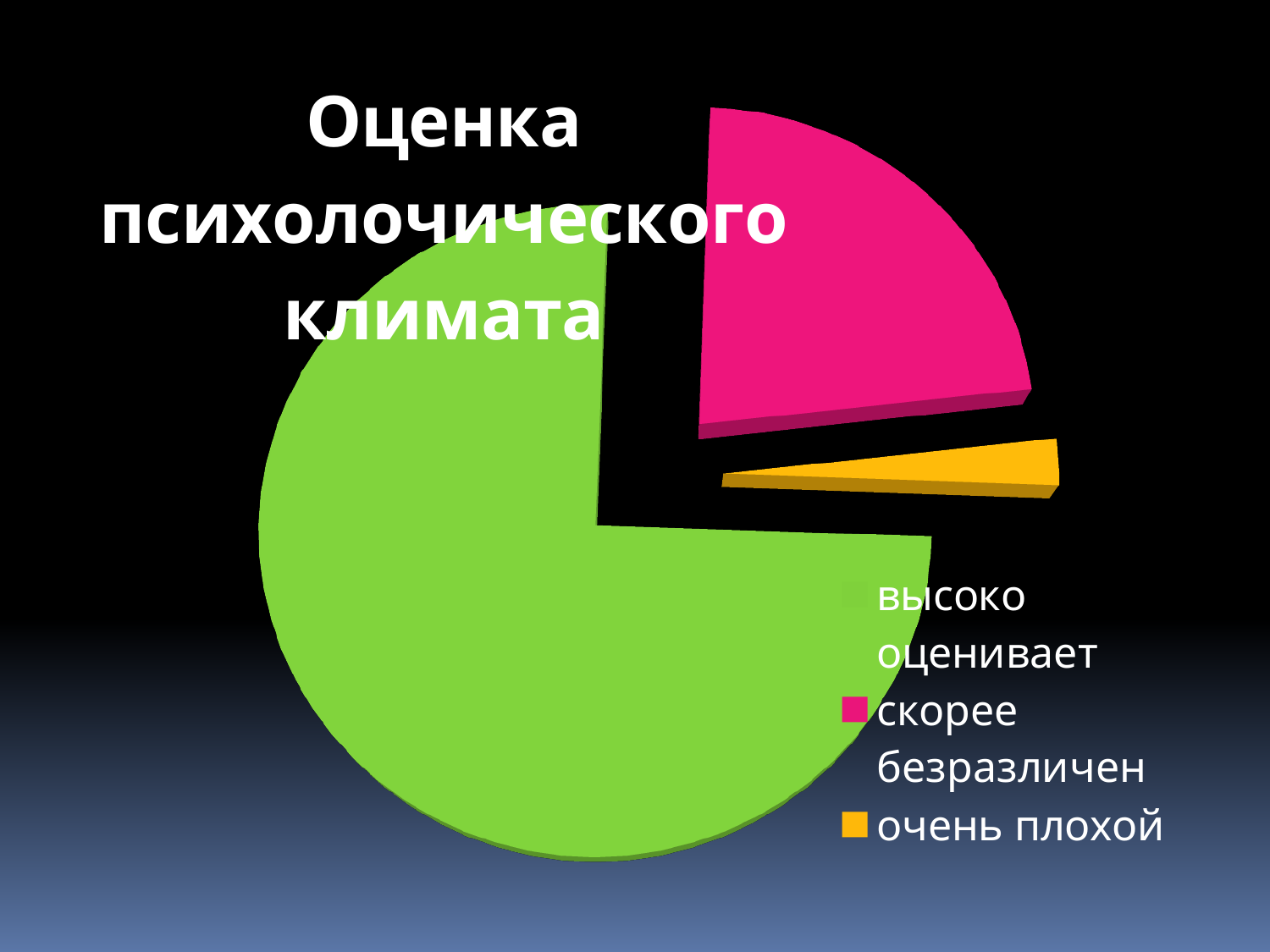
Which slice is larger: "высоко оценивает" or "скорее безразличен"? высоко оценивает How many entries does the legend list? 3 How many slices does the pie chart have? 3 Which slice is larger: "скорее безразличен" or "очень плохой"? скорее безразличен What colour is the slice for "скорее безразличен"? pink What is the title of the chart? Оценка психолочического климата Which category has the smallest slice of the pie? очень плохой What kind of chart is shown on the slide? pie chart Which category has the largest slice of the pie? высоко оценивает